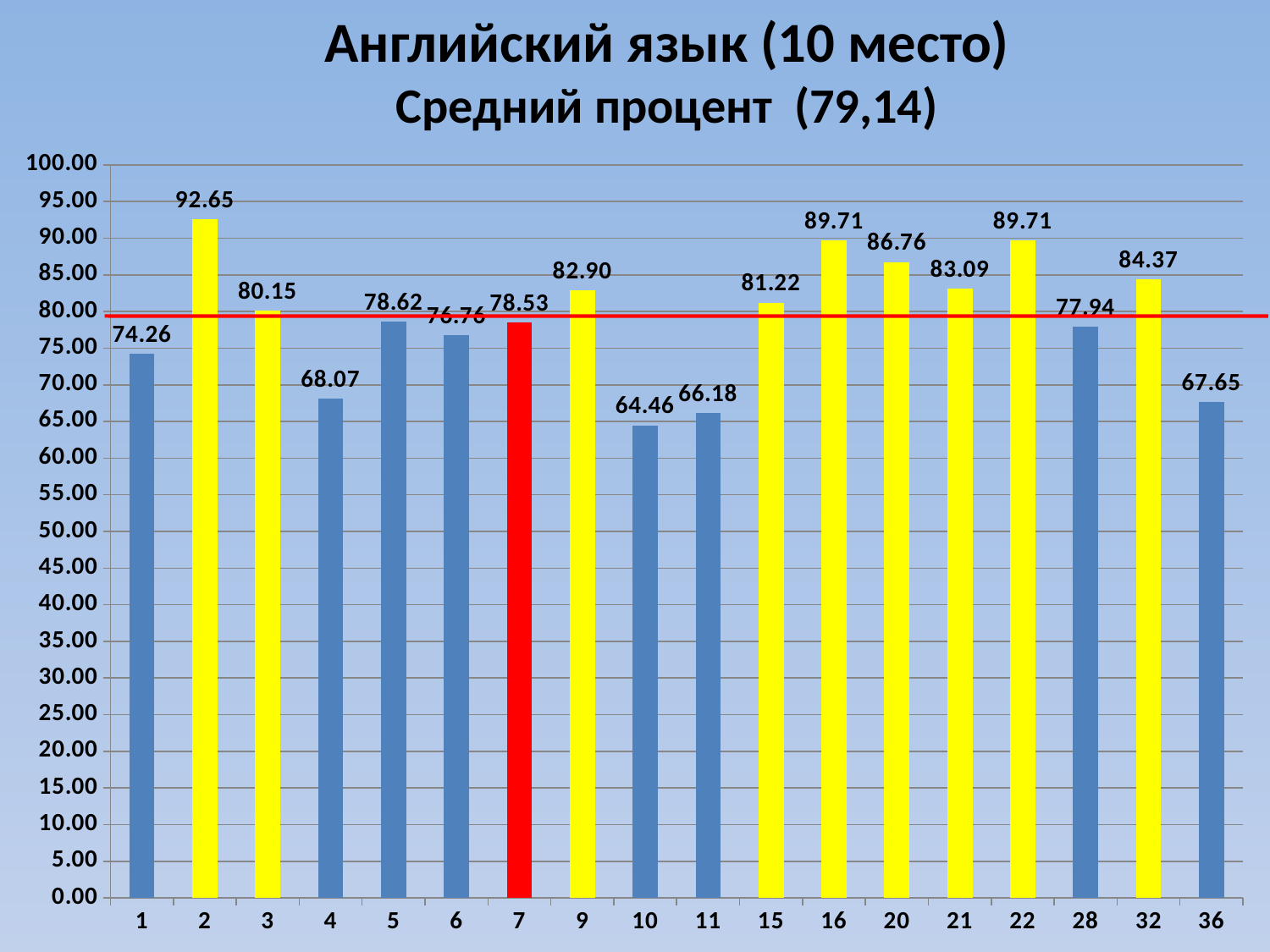
Which is larger, the value for category 4 or the value for category 36? category 4 What is the value for category 32? 84.37 What is the difference between the values for category 2 and category 10? 28.19 What average percentage is stated in the chart title? 79,14 Which category has the lowest value? 10 What is the difference between the values for category 16 and category 20? 2.95 What is the value for category 10? 64.46 What type of chart is shown on the slide? bar chart What is the value for category 2? 92.65 How many bars (categories) are plotted on the chart? 18 Which category has the highest value? 2 Which category's bar is coloured red? 7